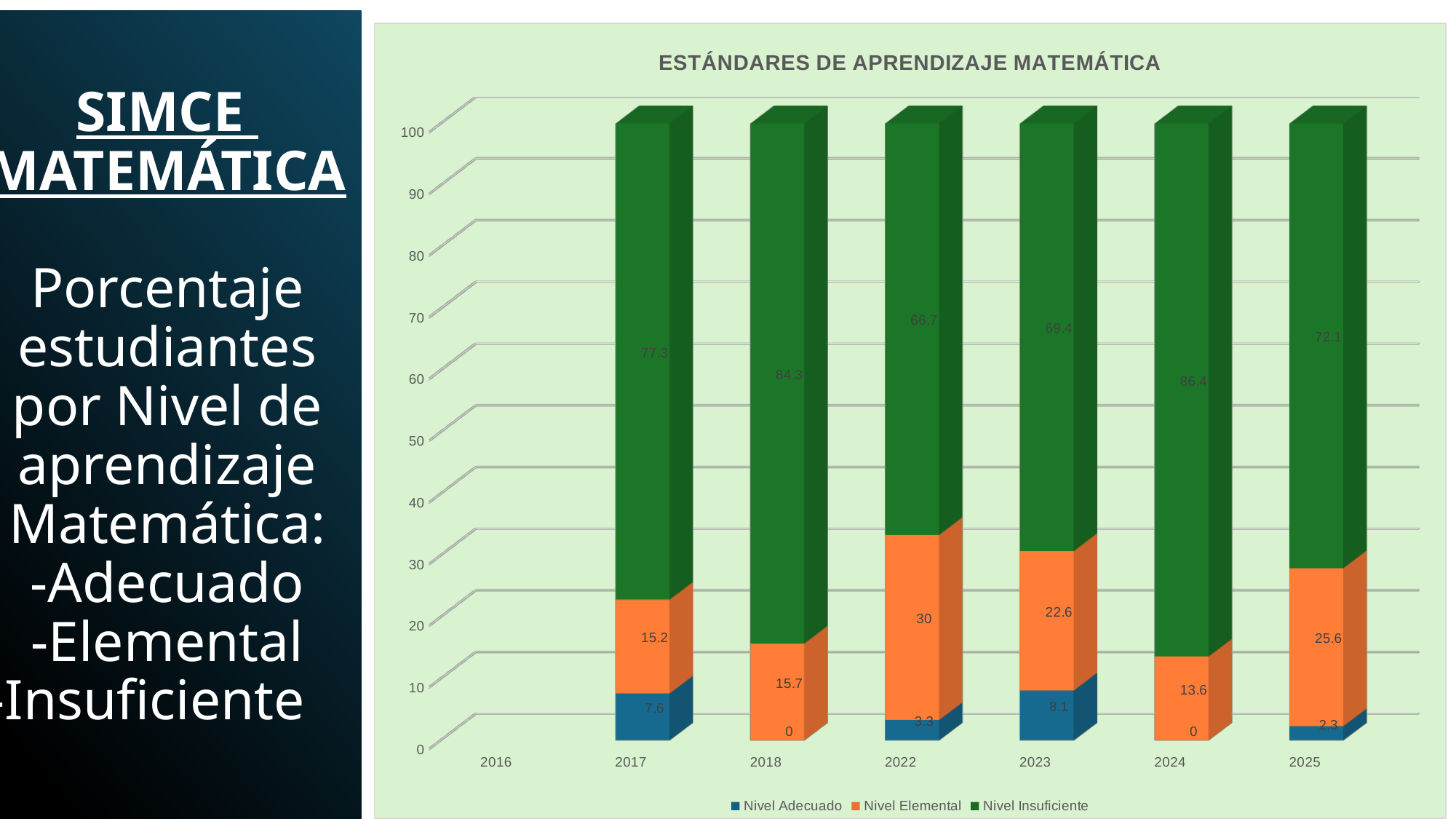
In which year is Nivel Elemental lowest? 2024 Which colour represents Nivel Insuficiente in the chart? Green What is the value of Nivel Insuficiente for 2024? 86.4 What type of chart is shown on the slide? Stacked bar chart What is the total of the stacked bar for 2024? 100 In which year is Nivel Insuficiente highest? 2024 Which is larger, Nivel Adecuado in 2023 or in 2017? 2023 What is the difference between Nivel Insuficiente in 2024 and in 2017? 9.1 What is the value of Nivel Adecuado for 2025? 2.3 What is the title of the chart? ESTÁNDARES DE APRENDIZAJE MATEMÁTICA What is the value of Nivel Elemental for 2022? 30 How many series does the legend list? 3